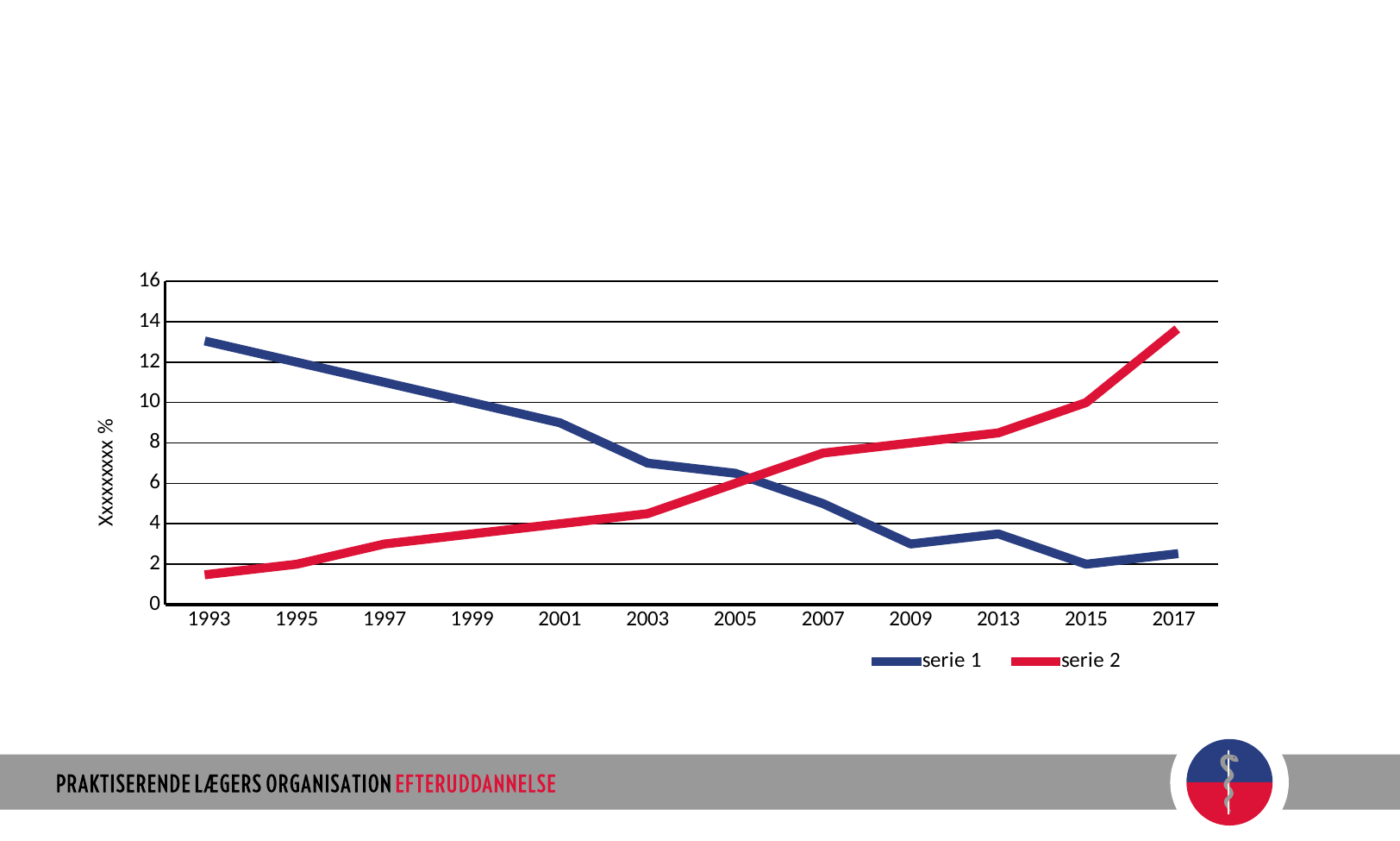
Does serie 2 rise or fall overall from 1993 to 2017? rise Is the value for serie 1 in 2009 greater or less than 4? less Which series has the larger value in 2017, serie 1 or serie 2? serie 2 In which year is serie 2 at its highest? 2017 In which year is serie 1 at its highest? 1993 How many series does the legend list? 2 What are the two entries in the legend? serie 1 and serie 2 What kind of chart is shown on the slide? line chart Which series has the larger value in 1993, serie 1 or serie 2? serie 1 In which year is serie 2 at its lowest? 1993 Does serie 1 rise or fall overall from 1993 to 2017? fall How many years are shown on the x axis? 12